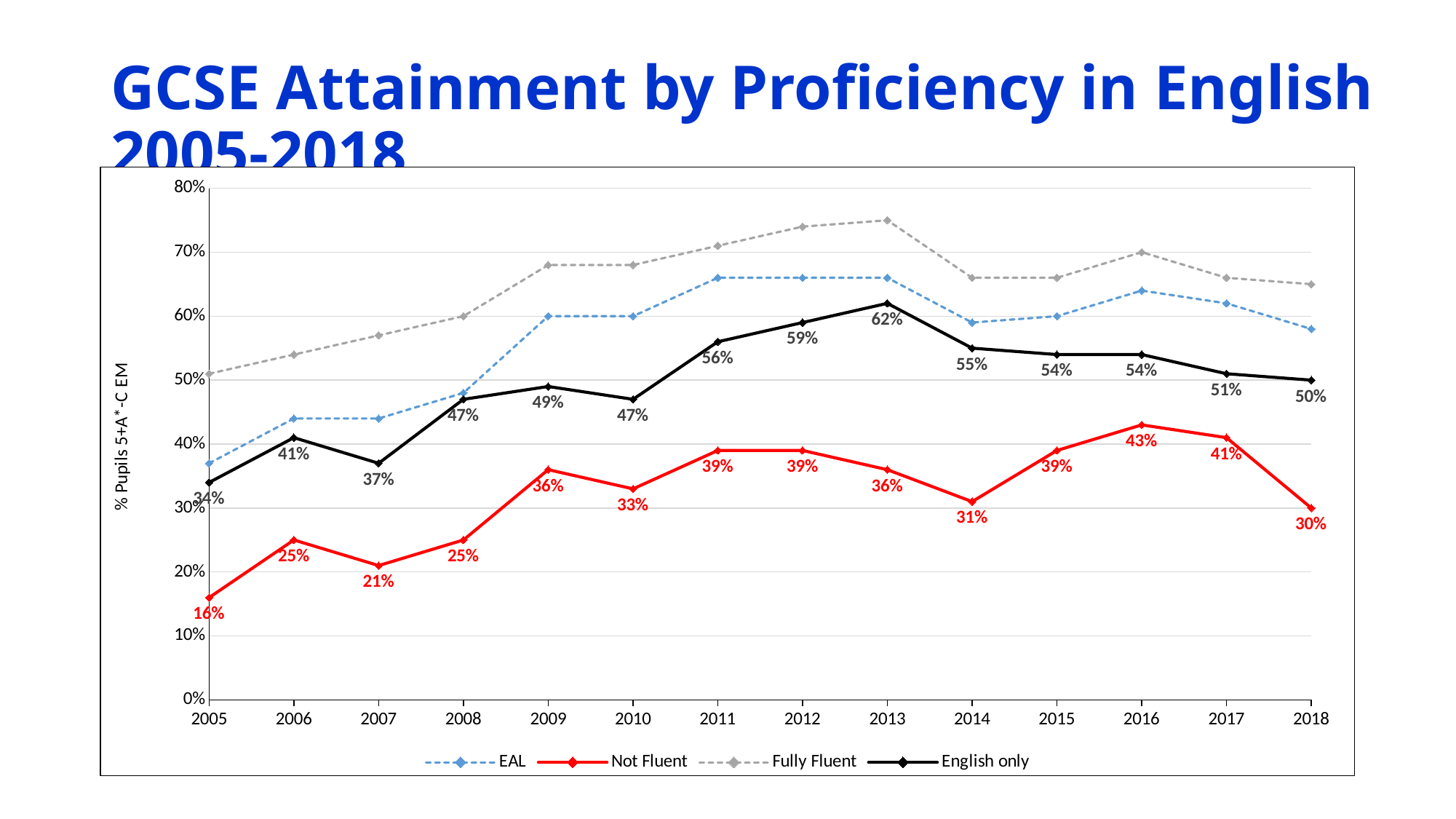
How many series does the legend list? 4 In which year is the English only value highest? 2013 What is the label on the y axis? % Pupils 5+A*-C EM What is the value for Not Fluent in 2016? 43% What is the value for English only in 2013? 62% In which year is the Not Fluent value lowest? 2005 Is the value for Fully Fluent in 2013 greater or less than 70%? greater What type of chart is shown on the slide? line chart Which is larger, the Not Fluent value in 2009 or in 2014? 2009 Does the Not Fluent value rise or fall from 2017 to 2018? fall How many years are plotted along the x axis? 14 What is the difference between the English only and Not Fluent values in 2018? 20%